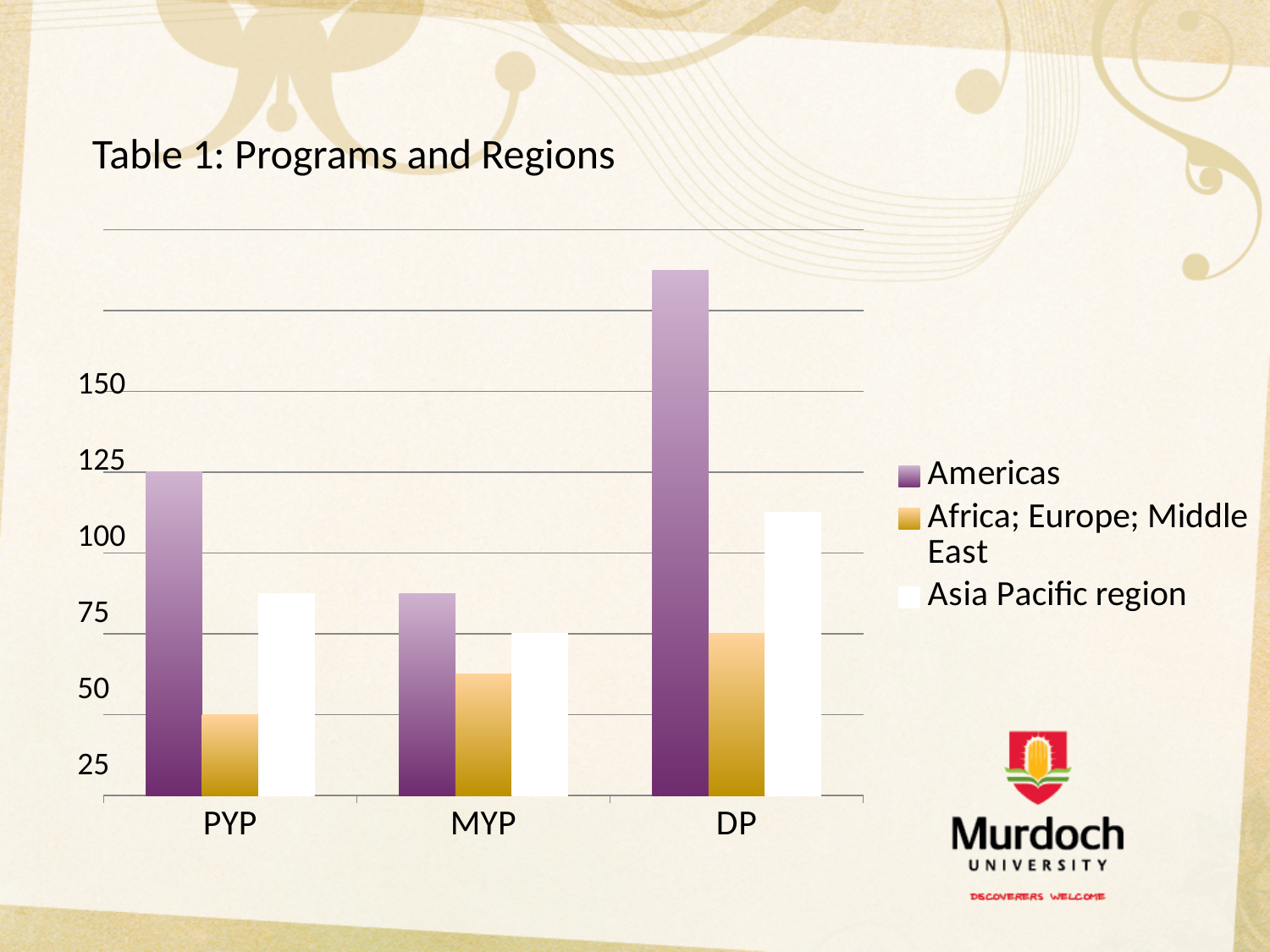
What is the title of the chart? Table 1: Programs and Regions For which program is the Africa; Europe; Middle East value lowest? PYP For which program is the Asia Pacific region value lowest? MYP In the PYP category, which is larger: Asia Pacific region or Africa; Europe; Middle East? Asia Pacific region Do the Africa; Europe; Middle East values rise or fall from PYP to DP? rise In the DP category, which is larger: Americas or Africa; Europe; Middle East? Americas Is the Americas value for DP greater or less than 150? greater Which series is shown in purple in the chart? Americas How many categories are shown on the x axis of the chart? 3 What kind of chart is shown on the slide? bar chart How many series does the chart's legend list? 3 For which program is the Americas value highest? DP